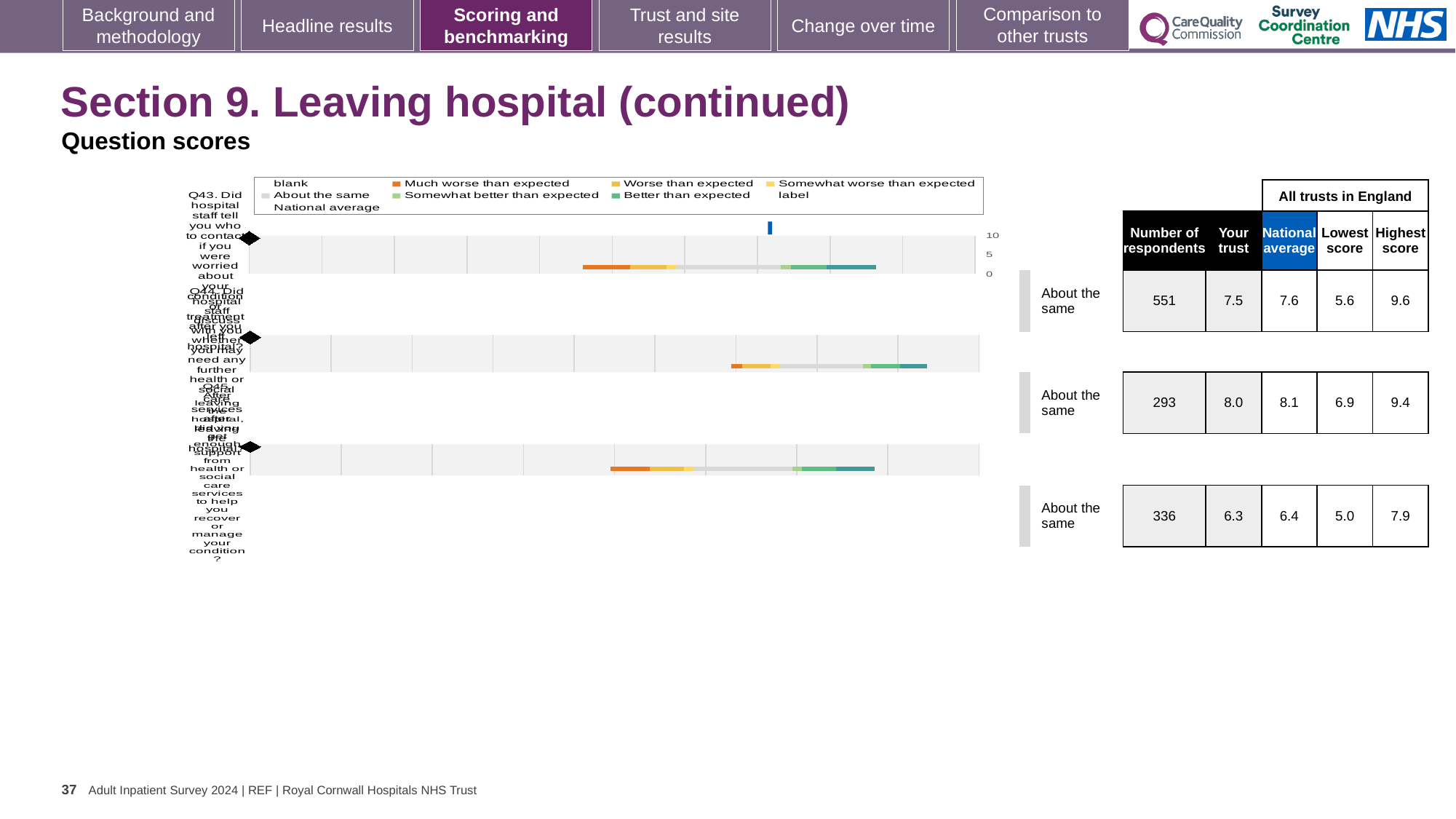
What is the highest tick value shown on the score axis of the top chart? 10 For the bottom chart (Q45), what is the difference between the highest score and the lowest score across all trusts in England? 2.9 For the top chart (Q43), what is the 'Your trust' score shown in the table? 7.5 What benchmark category is shown next to each of the three charts? About the same Which of the three questions has the lowest 'Your trust' score? Q45 For the middle chart (Q44), what is the national average score shown in the table? 8.1 Which of the three questions has the highest 'Your trust' score? Q44 Which legend entry is shown in dark orange in the chart legend? Much worse than expected What kind of chart is used to show the question scores on this slide? bar chart For the bottom chart (Q45), what is the number of respondents shown in the table? 336 How many question score charts are shown on the slide? 3 Which legend entry is shown in dark teal in the chart legend? Better than expected